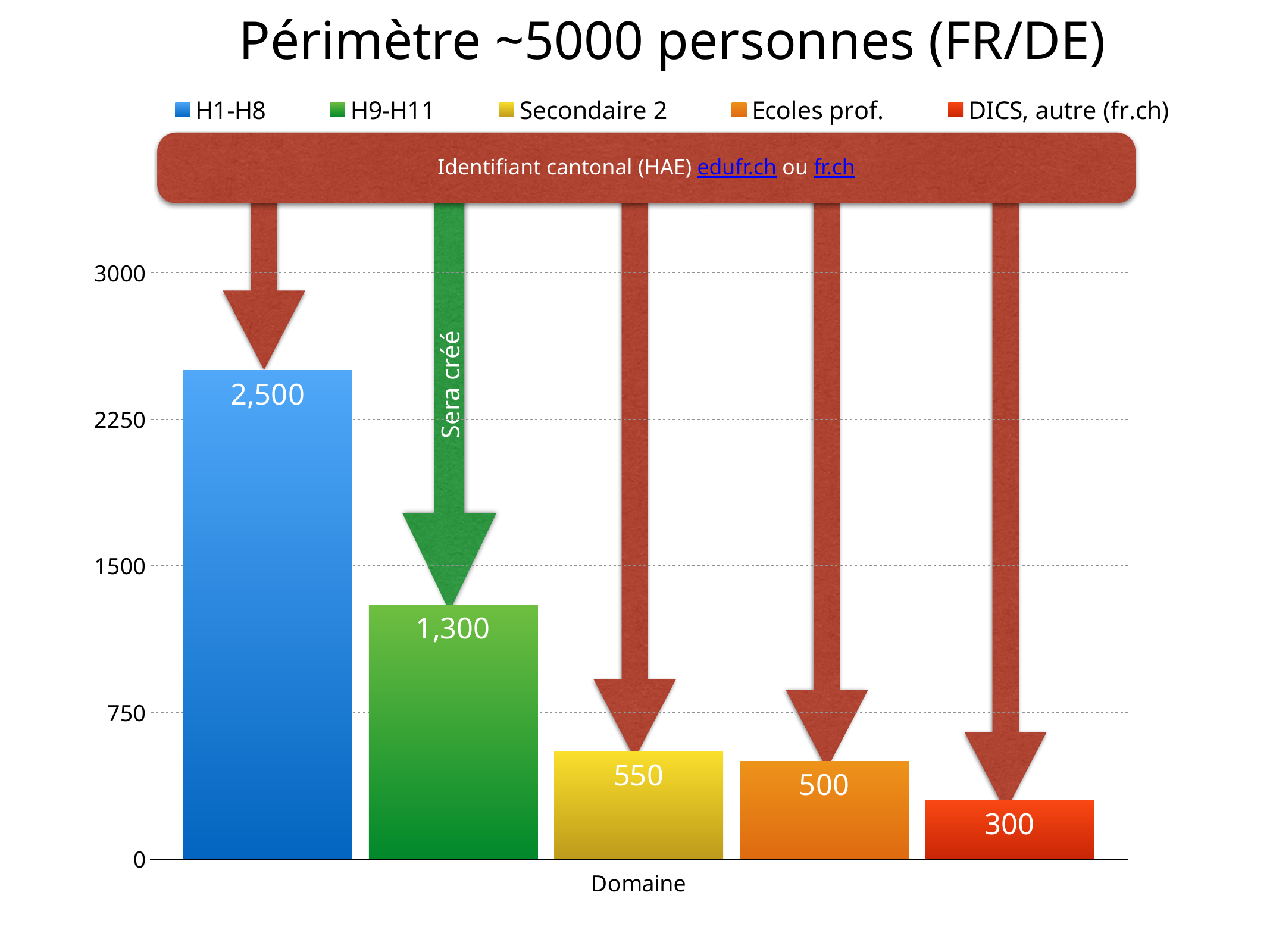
What is the value for H1-H8? 2,500 Which category has the lowest value? DICS, autre (fr.ch) What is the title of the chart? Périmètre ~5000 personnes (FR/DE) What is the difference between the values for H1-H8 and H9-H11? 1,200 What is the value for Ecoles prof.? 500 What is the value for H9-H11? 1,300 What is the value for Secondaire 2? 550 What is the value for DICS, autre (fr.ch)? 300 What kind of chart is shown on the slide? bar chart How many categories are shown in the chart? 5 Which category has the highest value? H1-H8 Which is larger, the value for Secondaire 2 or the value for Ecoles prof.? Secondaire 2